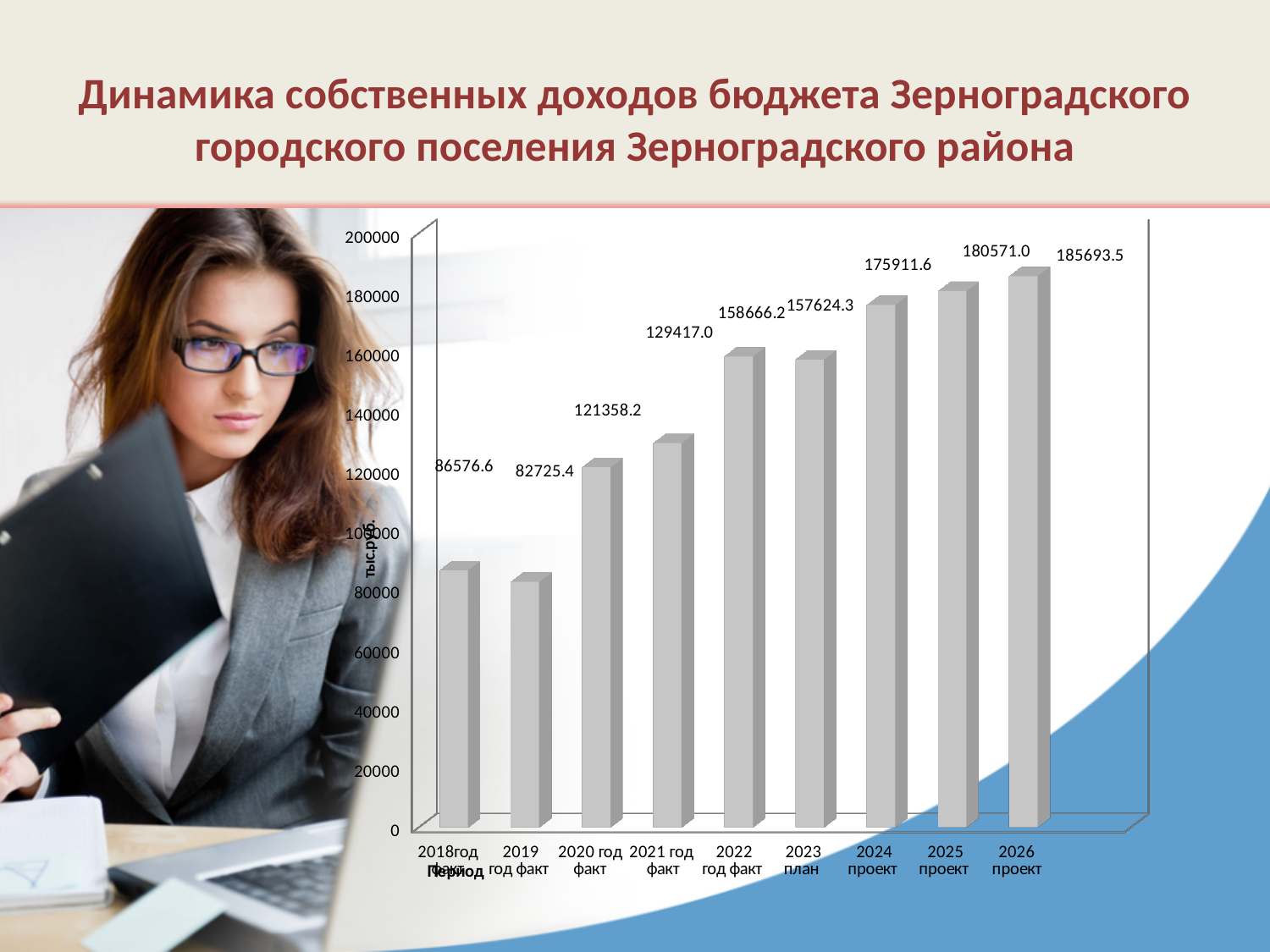
What is the value for 2020 год факт? 121358.2 What is the value for 2026 проект? 185693.5 What is the difference between the values for 2025 проект and 2024 проект? 4659.4 What unit is shown on the vertical axis label? тыс.руб. What kind of chart is shown on the slide? bar chart Which period has the lowest value? 2019 год факт Which period has the highest value? 2026 проект What is the value for 2023 план? 157624.3 Do the values generally rise or fall from 2019 год факт to 2026 проект? rise Which is larger, the value for 2022 год факт or 2023 план? 2022 год факт How many periods (bars) are shown in the chart? 9 Is the value for 2021 год факт greater or less than 120000? greater